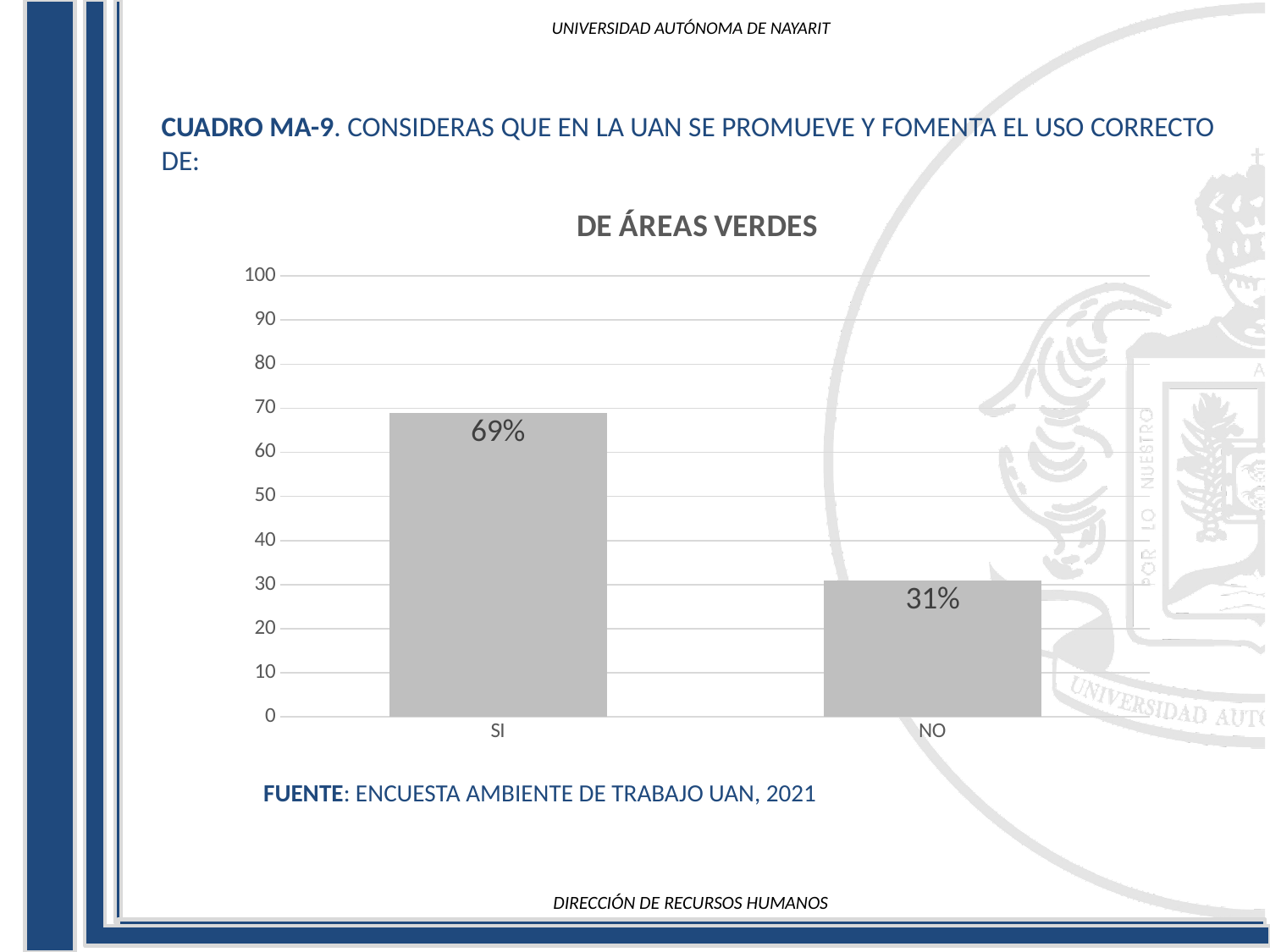
Is the value for NO greater or less than 40? less Which is larger, the value for SI or the value for NO? SI What is the difference between the values for SI and NO? 38% What is the title of the chart? DE ÁREAS VERDES Which category has the lowest value? NO Which category has the highest value? SI What is the highest value shown on the y axis? 100 Is the value for SI greater or less than 60? greater How many categories are shown on the x axis? 2 What is the value for SI? 69% What kind of chart is shown on the slide? bar chart What is the value for NO? 31%